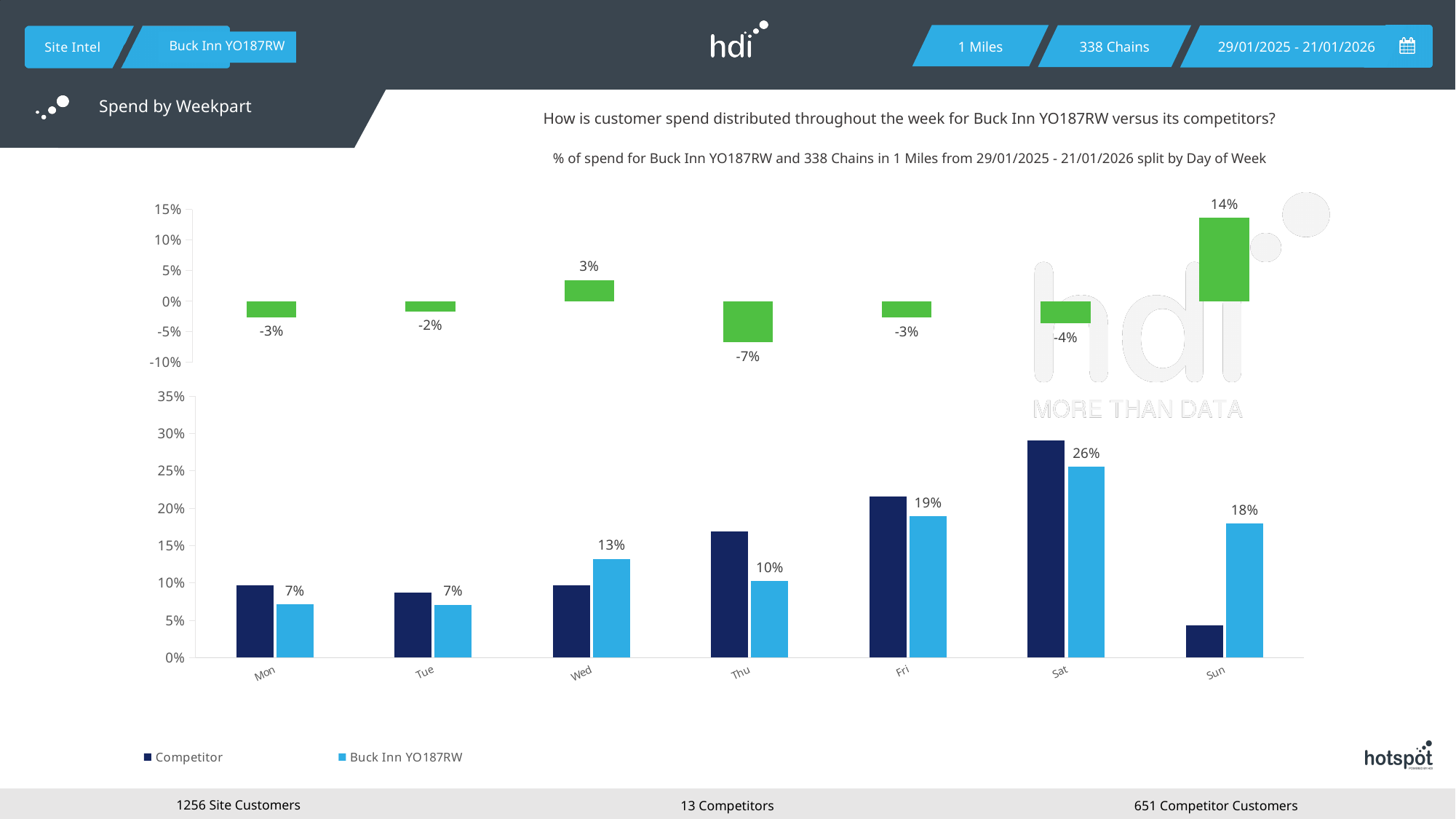
How many days of the week are shown on the x axis of the bottom chart? 7 In the bottom chart, what is the value for Buck Inn YO187RW on Sat? 26% In the top chart (green bars), what is the value for Thu? -7% In the top chart (green bars), which day has the highest value? Sun In the bottom chart, is the Competitor value for Sun greater or less than 5%? less In the top chart (green bars), which day has the lowest value? Thu In the bottom chart, is the Competitor value for Sat greater or less than 25%? greater In the bottom chart, what is the value for Buck Inn YO187RW on Wed? 13% In the bottom chart, which is larger on Fri: the Competitor bar or the Buck Inn YO187RW bar? Competitor In the bottom chart, what is the difference between the Buck Inn YO187RW values for Sat and Sun? 8% In the bottom chart, which day has the highest Buck Inn YO187RW value? Sat How many series does the legend of the bottom chart list? 2